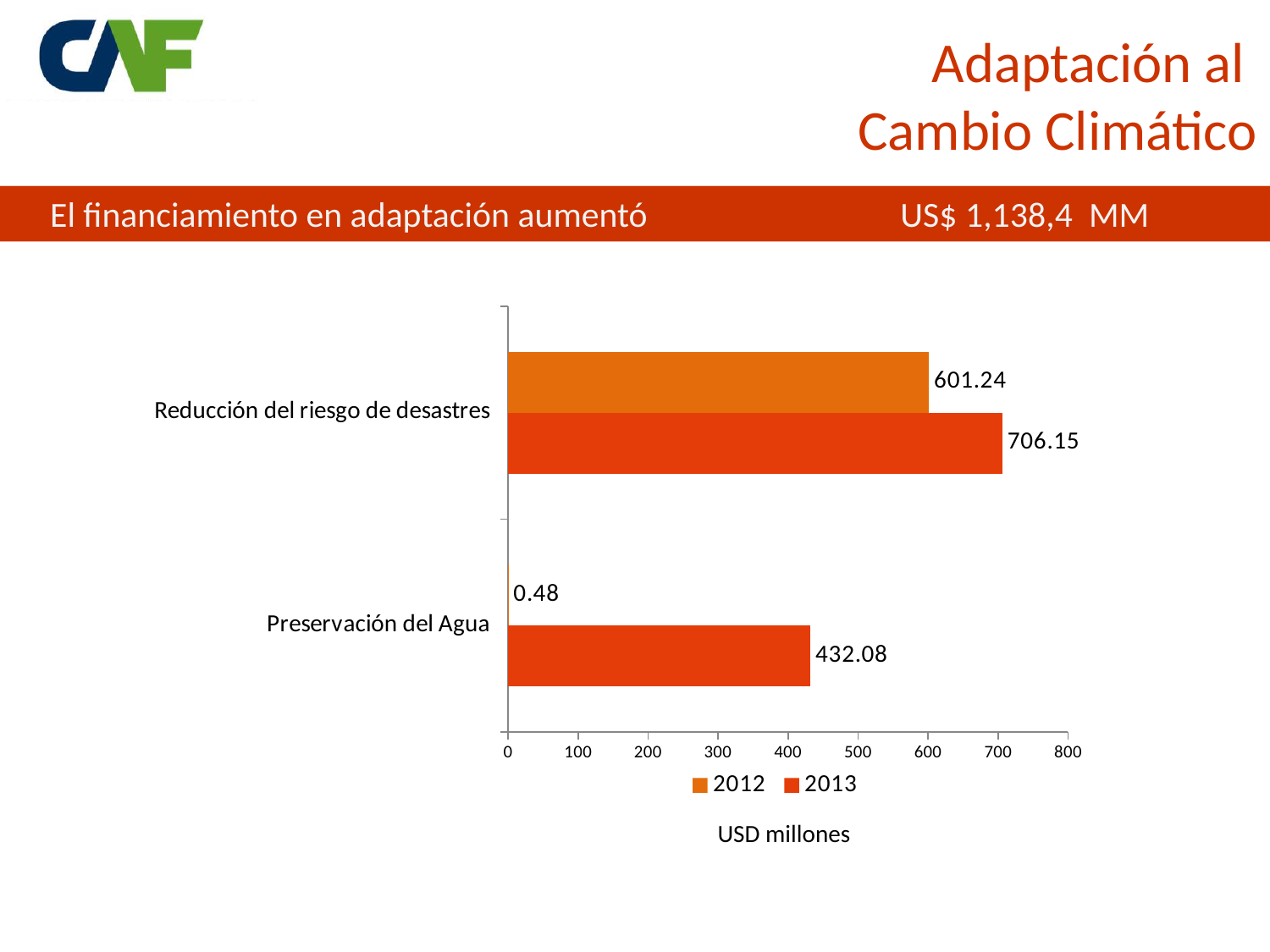
What is the 2013 value for Reducción del riesgo de desastres? 706.15 What is the 2012 value for Preservación del Agua? 0.48 What kind of chart is shown on the slide? Bar chart Which is larger for Preservación del Agua, the 2012 value or the 2013 value? 2013 What is the difference between the 2013 and 2012 values for Reducción del riesgo de desastres? 104.91 What unit is given below the chart's legend? USD millones What is the 2013 value for Preservación del Agua? 432.08 What is the 2012 value for Reducción del riesgo de desastres? 601.24 How many series does the legend list? 2 Which category has the highest 2013 value? Reducción del riesgo de desastres How many categories are shown on the chart? 2 Which category has the lowest 2012 value? Preservación del Agua